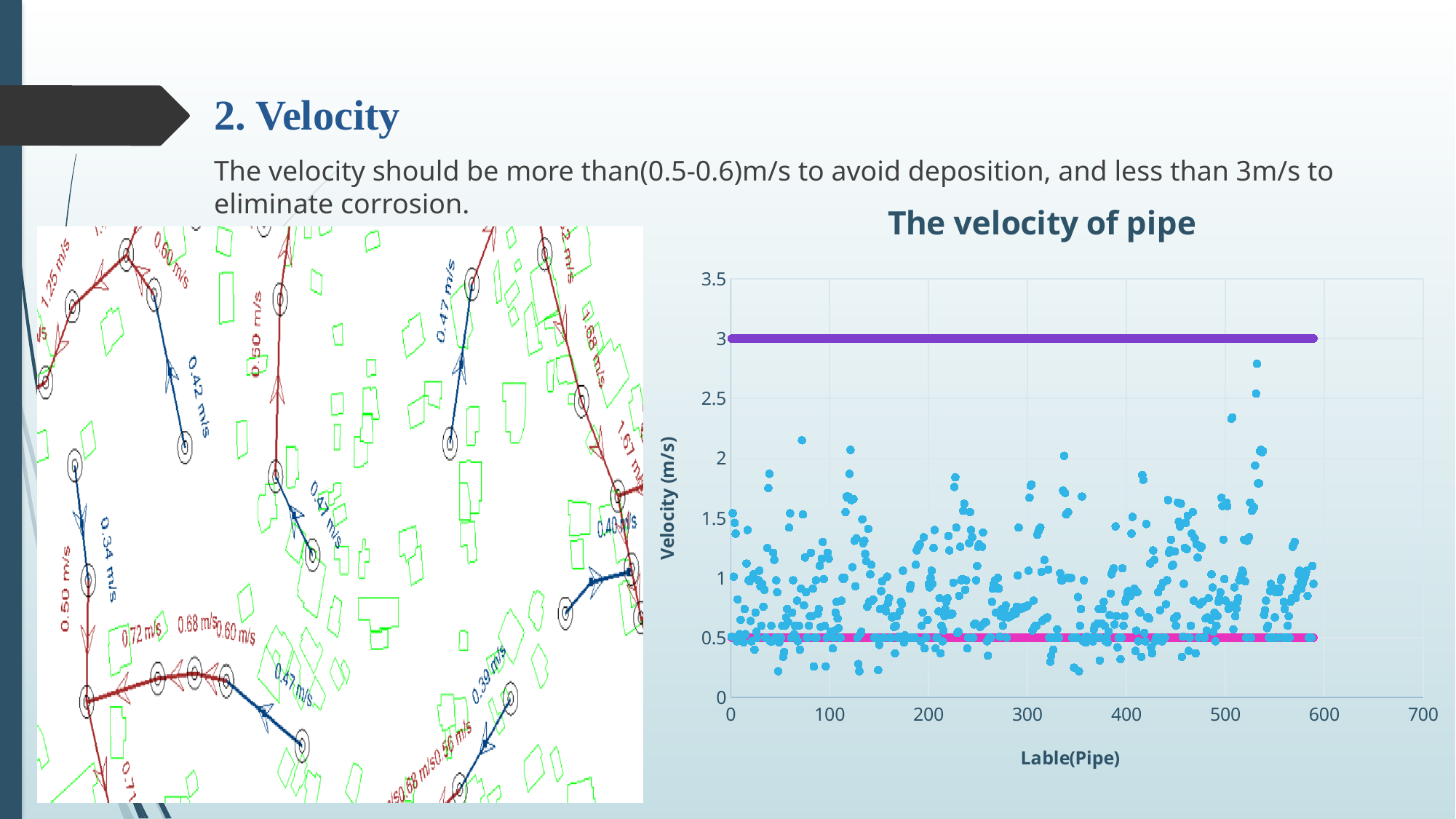
In the chart "The velocity of pipe", what is the difference in velocity between the purple line and the pink line? 2.5 In the chart "The velocity of pipe", is the highest blue scatter point greater or less than 2.5? greater In the chart "The velocity of pipe", is the highest blue scatter point greater or less than 3? less In the chart "The velocity of pipe", is the lowest blue scatter point greater or less than 0.5? less What kind of chart is "The velocity of pipe"? scatter chart What is the y-axis title of the chart "The velocity of pipe"? Velocity (m/s) In the chart "The velocity of pipe", at what velocity is the pink horizontal line drawn? 0.5 In the chart "The velocity of pipe", which horizontal line is at a higher velocity, the purple line or the pink line? the purple line In the chart "The velocity of pipe", at what velocity is the purple horizontal line drawn? 3 What is the title of the chart on the right of the slide? The velocity of pipe